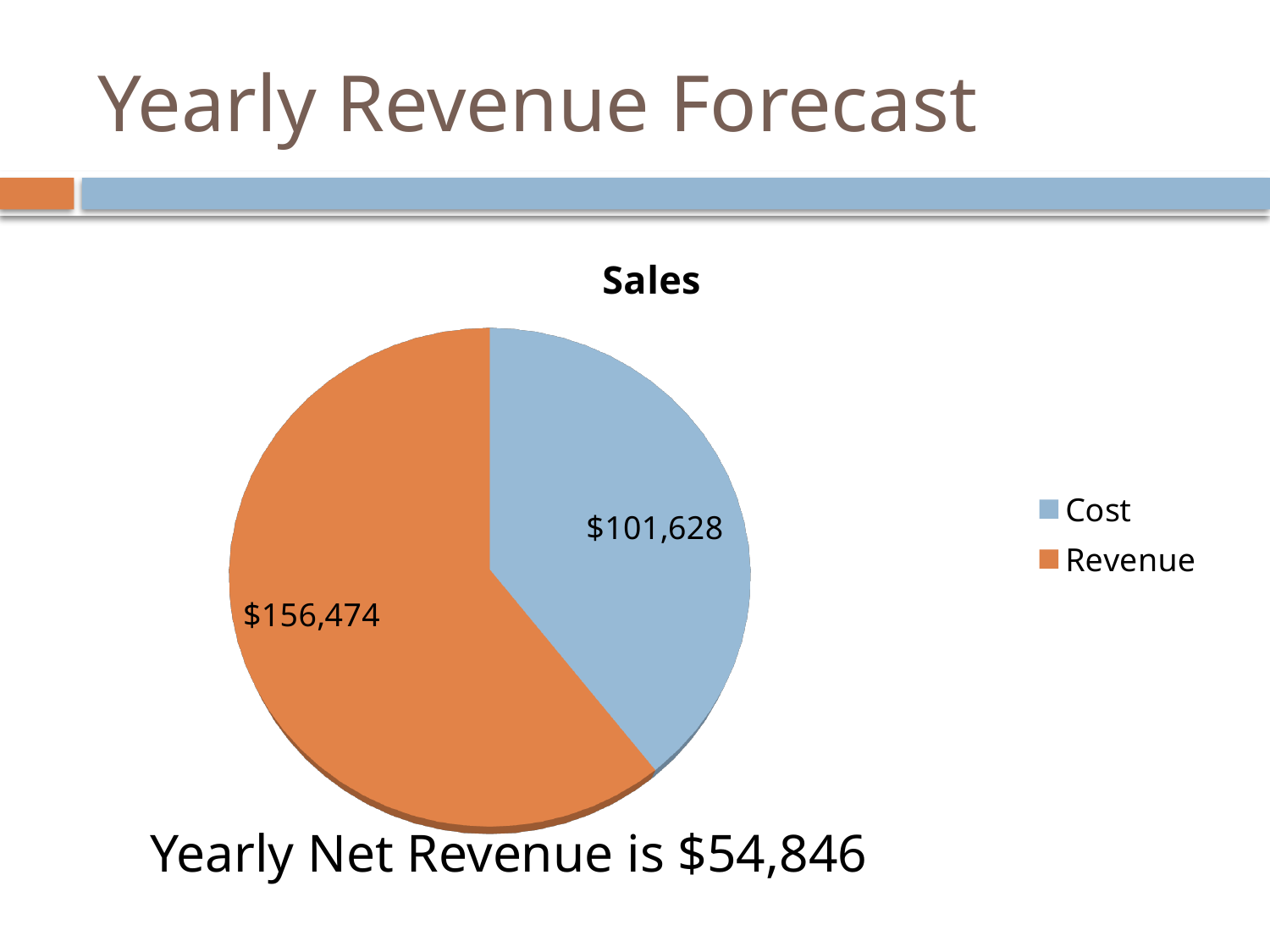
What type of chart is shown on the slide? pie chart What is the value of the Cost slice? $101,628 What is the title of the chart? Sales How many slices does the pie chart have? 2 How many entries does the legend list? 2 What is the total of Cost and Revenue? $258,102 Which slice is the largest? Revenue What is the difference between Revenue and Cost? $54,846 What is the value of the Revenue slice? $156,474 Which is larger, Cost or Revenue? Revenue What colour is the Revenue slice? orange Which slice is the smallest? Cost